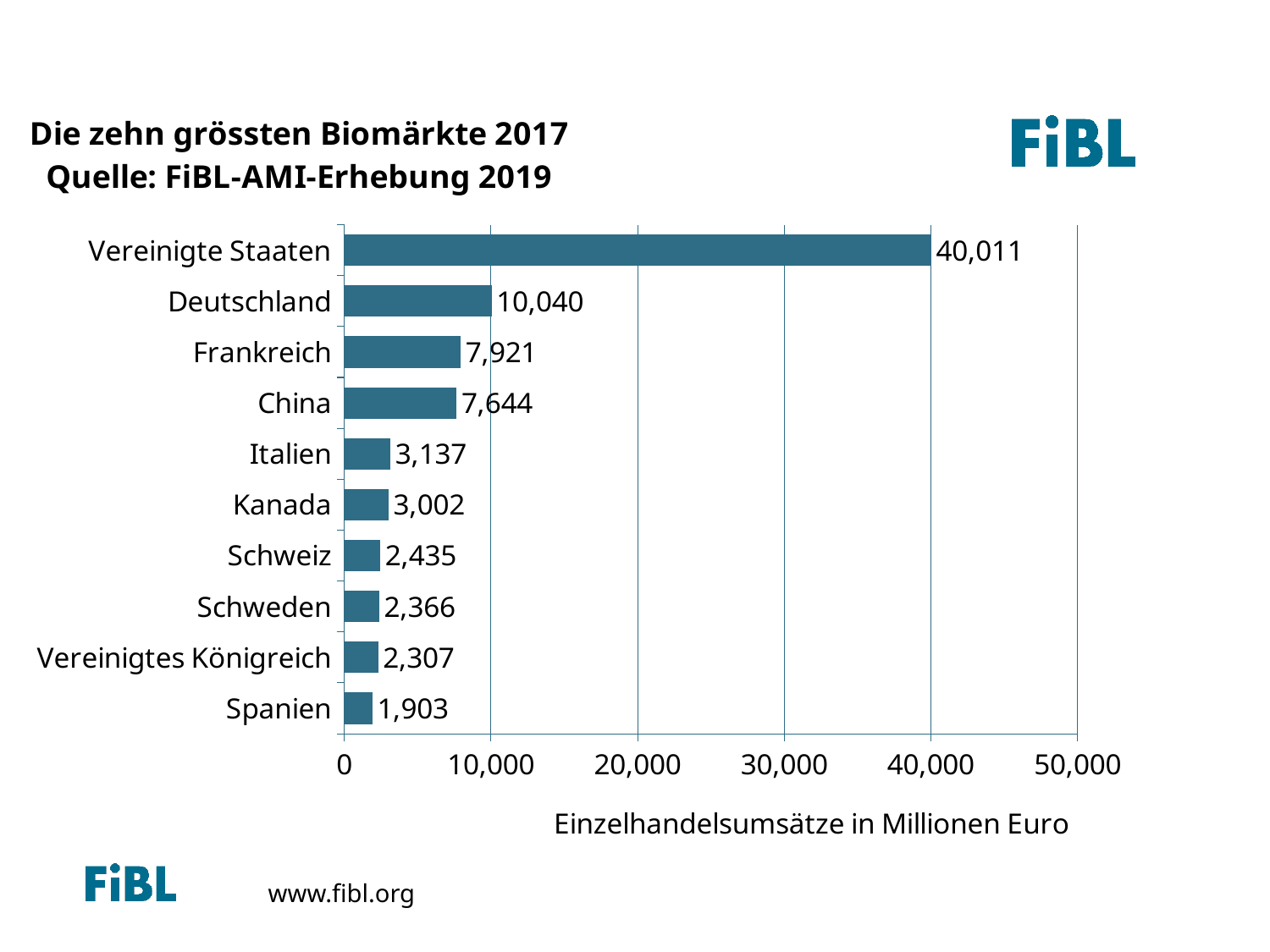
What is the value for Schweiz? 2,435 Is the value for Frankreich greater or less than 10,000? less What is the difference between the values for Vereinigte Staaten and Deutschland? 29,971 What is the value for Deutschland? 10,040 What is the x-axis label of the chart? Einzelhandelsumsätze in Millionen Euro What is the difference between the values for Frankreich and China? 277 What is the value for China? 7,644 Which country has the highest value? Vereinigte Staaten What kind of chart is shown on the slide? bar chart How many countries are shown in the chart? 10 Which is larger, the value for Italien or the value for Kanada? Italien Which country has the lowest value? Spanien